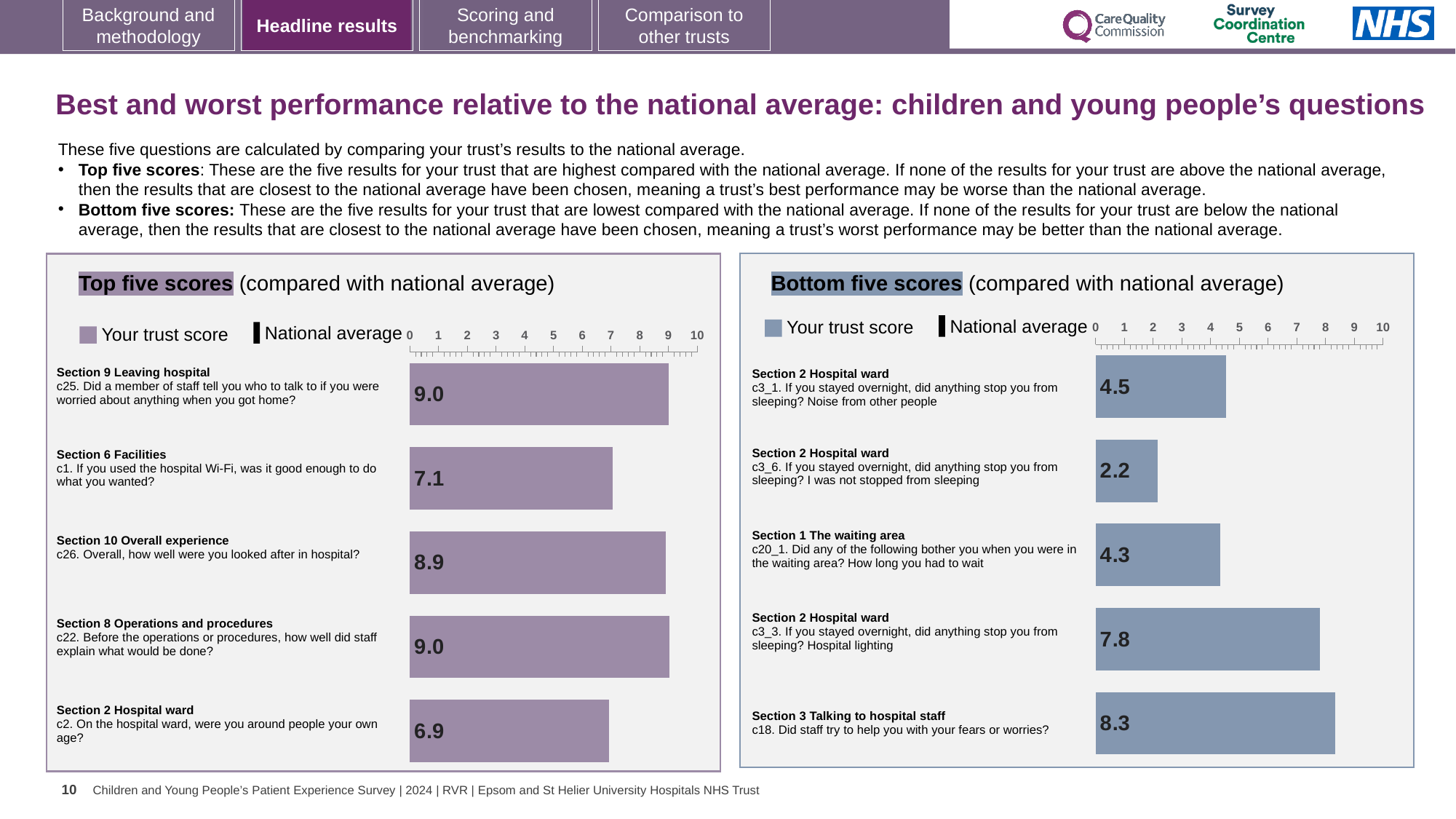
In the Bottom five scores chart, which has the larger trust score: c3_1 (Noise from other people) or c20_1 (How long you had to wait)? c3_1 (Noise from other people) In the Top five scores chart, what is the trust score for c26 (Overall, how well were you looked after in hospital?)? 8.9 In the Top five scores chart, what is the trust score for c1 (If you used the hospital Wi-Fi, was it good enough to do what you wanted?)? 7.1 How many questions are plotted in the Top five scores chart? 5 How many series does the legend of the Bottom five scores chart list? 2 In the Bottom five scores chart, which question has the lowest trust score? c3_6. If you stayed overnight, did anything stop you from sleeping? I was not stopped from sleeping In the Top five scores chart, what is the difference between the trust scores for c25 and c2? 2.1 In the Bottom five scores chart, what is the trust score for c3_3 (did anything stop you from sleeping? Hospital lighting)? 7.8 In the Top five scores chart, which question has the lowest trust score? c2. On the hospital ward, were you around people your own age? What kind of chart is the Top five scores chart? Bar chart In the Bottom five scores chart, what is the difference between the trust scores for c18 and c3_6? 6.1 In the Bottom five scores chart, which question has the highest trust score? c18. Did staff try to help you with your fears or worries?